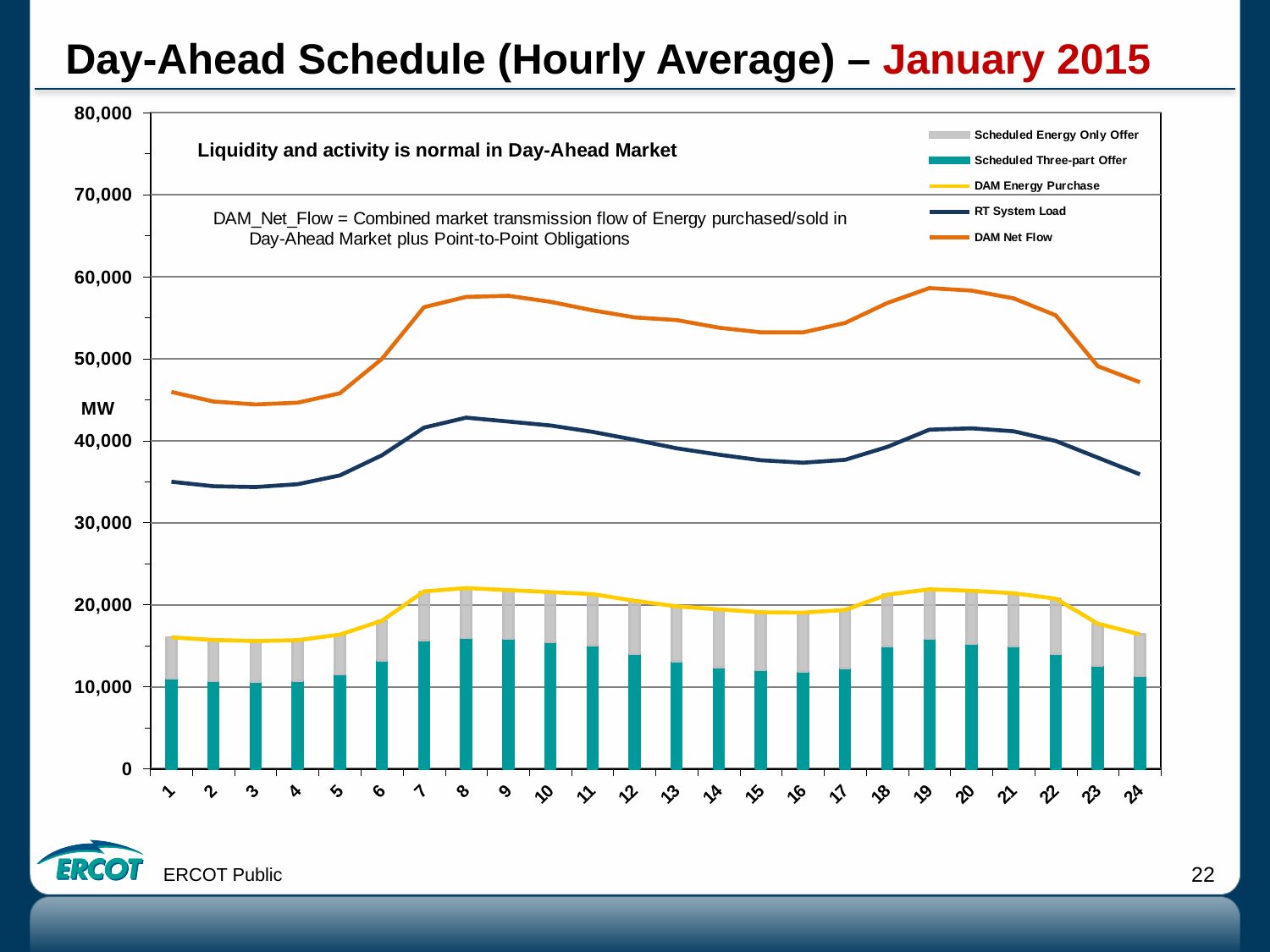
How many series does the legend list? 5 Which is larger, the RT System Load at hour 8 or at hour 16? Hour 8 How many hours are plotted along the x axis? 24 What kind of chart is shown on the slide? A combined bar and line chart Does the RT System Load rise or fall from hour 8 to hour 16? Fall Does the DAM Net Flow rise or fall from hour 1 to hour 8? Rise Is the RT System Load value at hour 8 greater or less than 40,000? greater What colour is the DAM Net Flow line in the legend? Orange Is the DAM Net Flow value at hour 1 greater or less than 50,000? less Is the Scheduled Three-part Offer value at hour 8 greater or less than 10,000? greater Which is larger, the DAM Net Flow at hour 1 or at hour 7? Hour 7